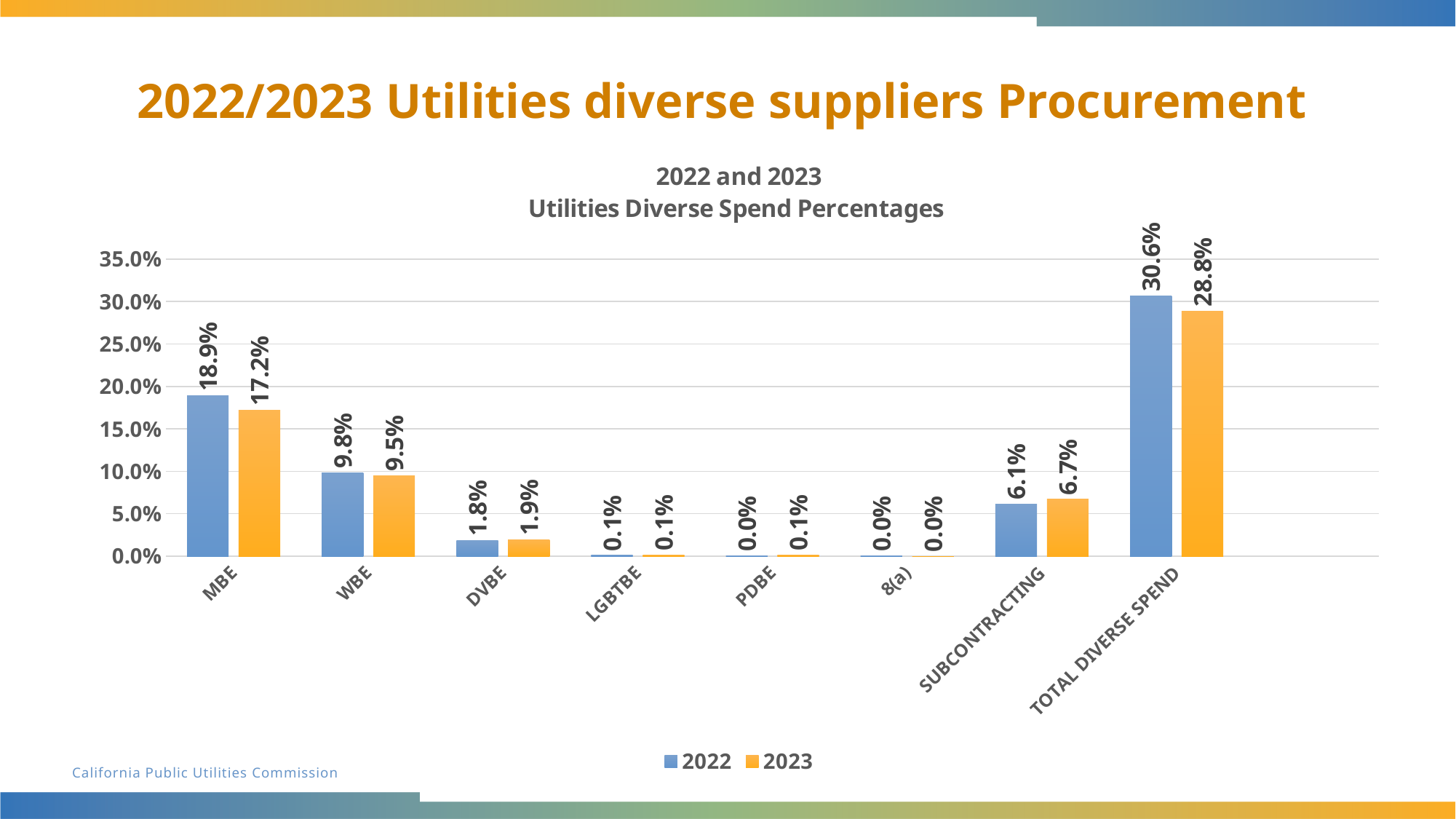
What is the 2022 value for MBE? 18.9% What is the difference between the 2022 and 2023 values for MBE? 1.7% What kind of chart is shown? bar chart How many categories are shown on the x axis? 8 Which category has the lowest 2023 value? 8(a) What is the difference between the 2022 and 2023 values for TOTAL DIVERSE SPEND? 1.8% Is the 2022 value for WBE greater or less than 10.0%? less What is the 2023 value for SUBCONTRACTING? 6.7% How many series does the legend list? 2 Which category has the highest 2022 value? TOTAL DIVERSE SPEND What is the 2023 value for TOTAL DIVERSE SPEND? 28.8% Which is larger for SUBCONTRACTING, the 2022 value or the 2023 value? 2023